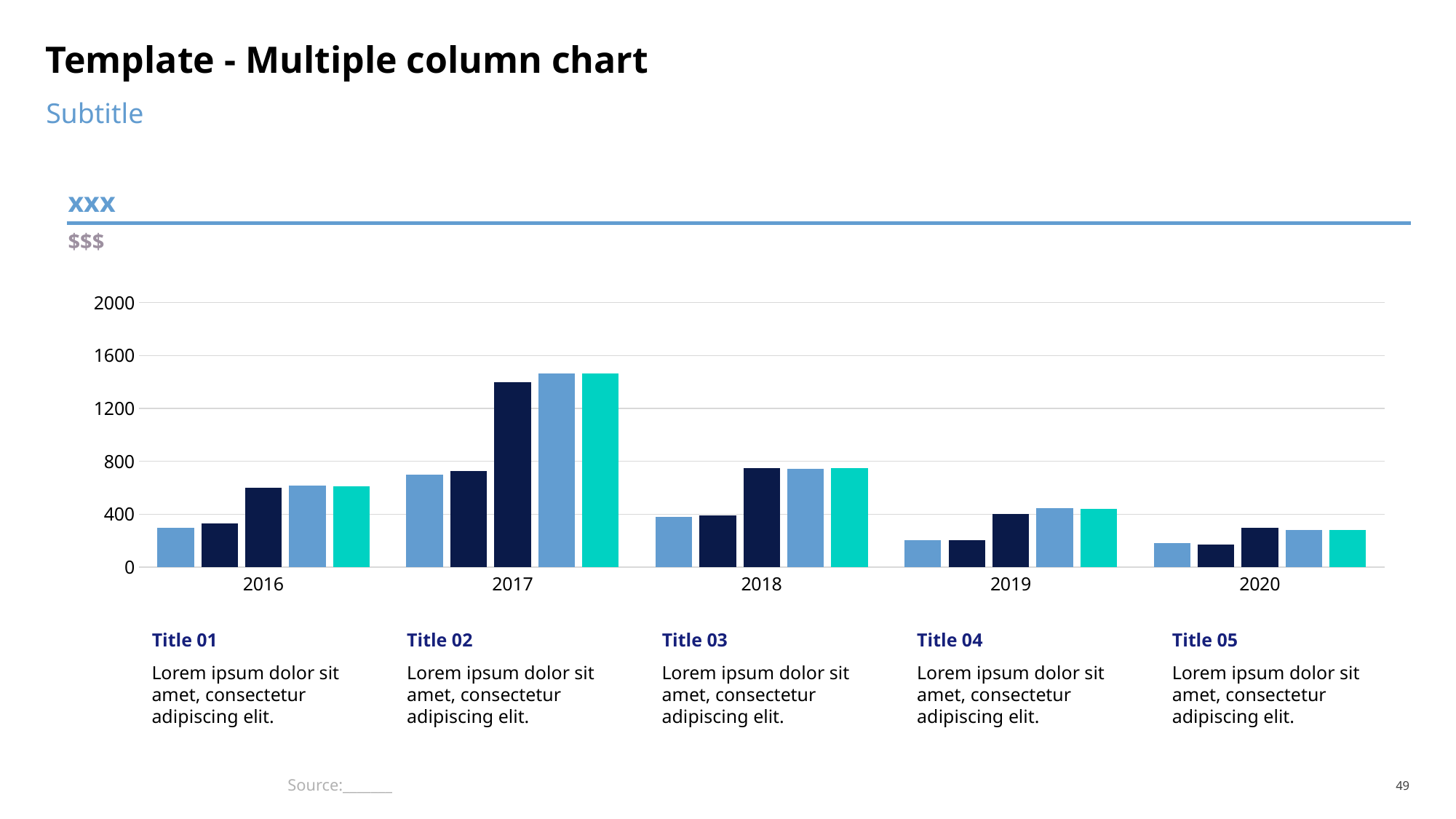
What kind of chart is shown on the slide? bar chart Are all the bars for 2016 greater or less than 800? less How many years are shown on the x axis of the chart? 5 What is the highest value shown on the y axis of the chart? 2000 Are all the bars for 2020 greater or less than 400? less Which year contains the tallest bar in the chart? 2017 Which year has the lowest bars overall, 2019 or 2020? 2020 How many bars are plotted for each year in the chart? 5 Is the tallest bar for 2018 greater or less than 800? less Do the bar heights generally rise or fall from 2017 to 2020? fall Which year has the taller tallest bar, 2017 or 2018? 2017